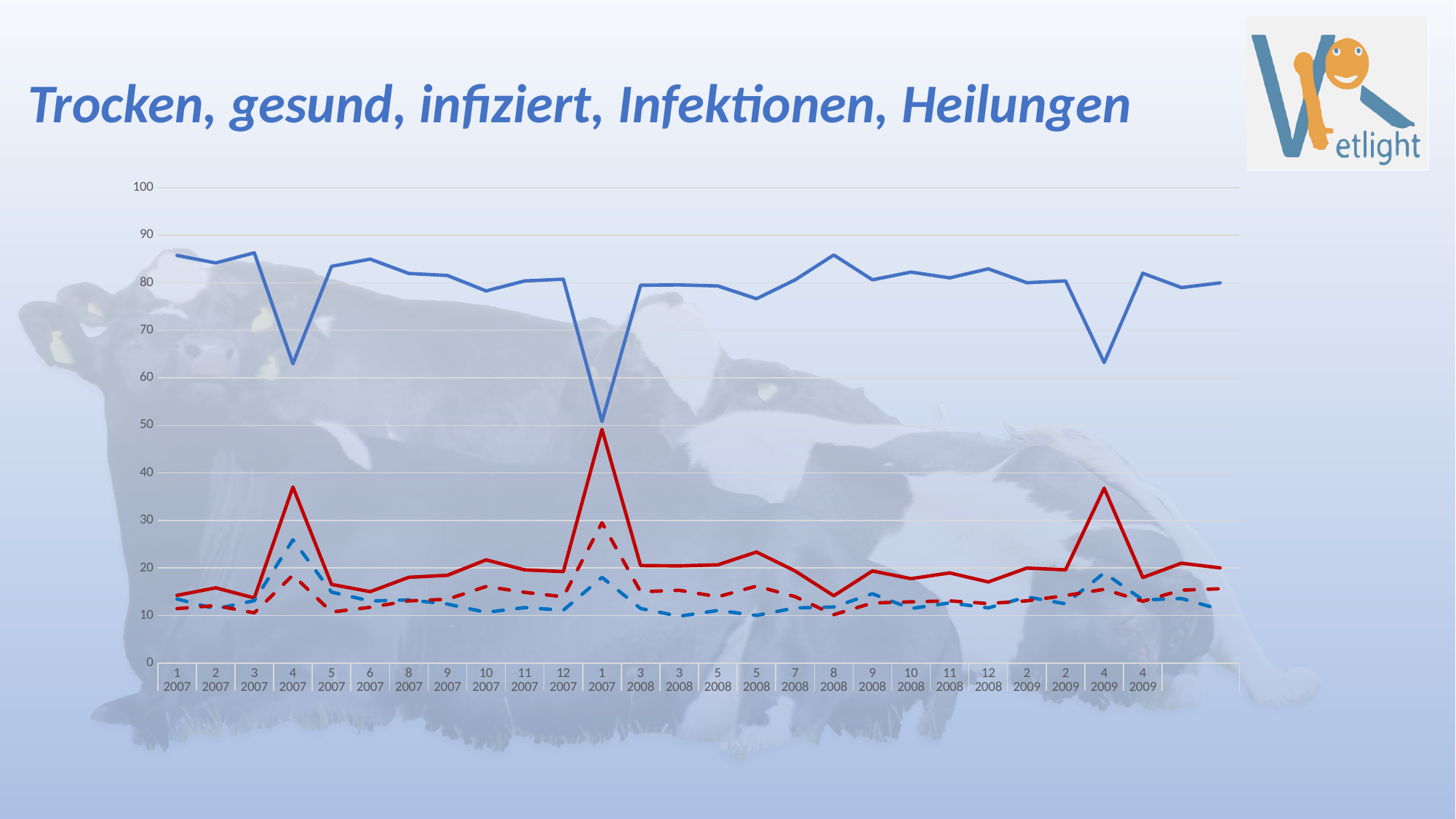
What is the title of the slide above the chart? Trocken, gesund, infiziert, Infektionen, Heilungen At which x-axis label does the solid blue line reach its lowest point? 1 2007 (the point between 12 2007 and 3 2008) How many lines are plotted in the chart? 4 Which line stays highest across the whole chart? solid blue line What is the highest value shown on the vertical axis? 100 At 4 2007, which is larger: the solid blue line or the solid red line? solid blue line Is the value of the solid blue line at 4 2007 greater or less than 70? less What kind of chart is shown on the slide? line chart Is the value of the solid red line at 4 2007 greater or less than 30? greater Is the value of the solid blue line at 1 2007 (the first point) greater or less than 80? greater